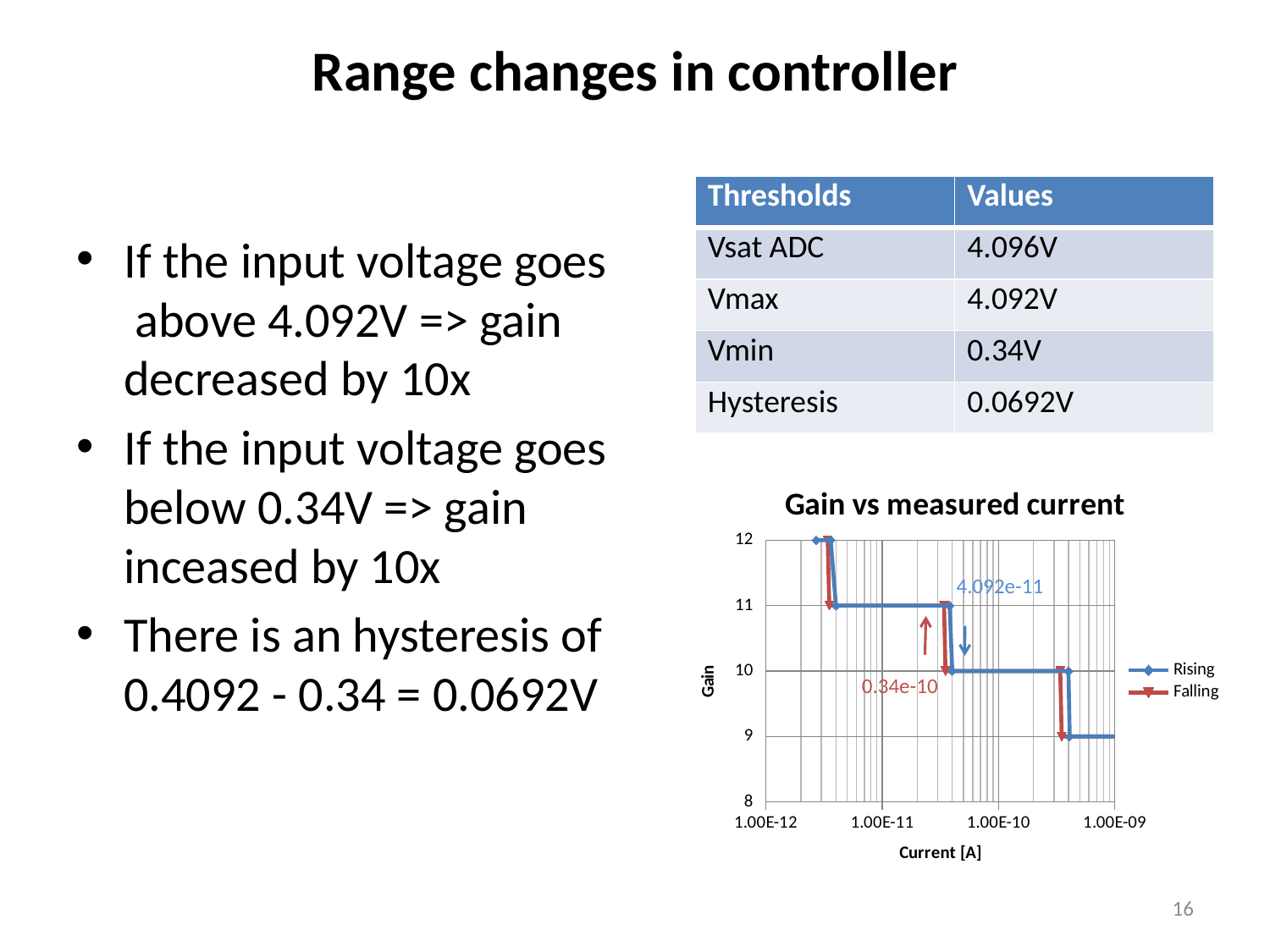
In the "Gain vs measured current" chart, does the gain rise or fall as the current increases? fall In the "Gain vs measured current" chart, is the gain at 1.00E-09 A greater or less than 10? less What kind of chart is "Gain vs measured current"? line chart How many distinct gain levels (steps) do the lines in the "Gain vs measured current" chart show? 4 In the "Gain vs measured current" chart, what is the gain at a current of 1.00E-10 A? 10 What is the highest gain value reached by the lines in the "Gain vs measured current" chart? 12 What are the two series named in the legend of the "Gain vs measured current" chart? Rising and Falling What is the lowest gain value reached by the lines in the "Gain vs measured current" chart? 9 In the "Gain vs measured current" chart, what is the gain at a current of 1.00E-11 A? 11 What is the label of the x axis in the "Gain vs measured current" chart? Current [A] In the "Gain vs measured current" chart, what is the gain at a current of 1.00E-09 A? 9 How many series does the legend of the "Gain vs measured current" chart list? 2